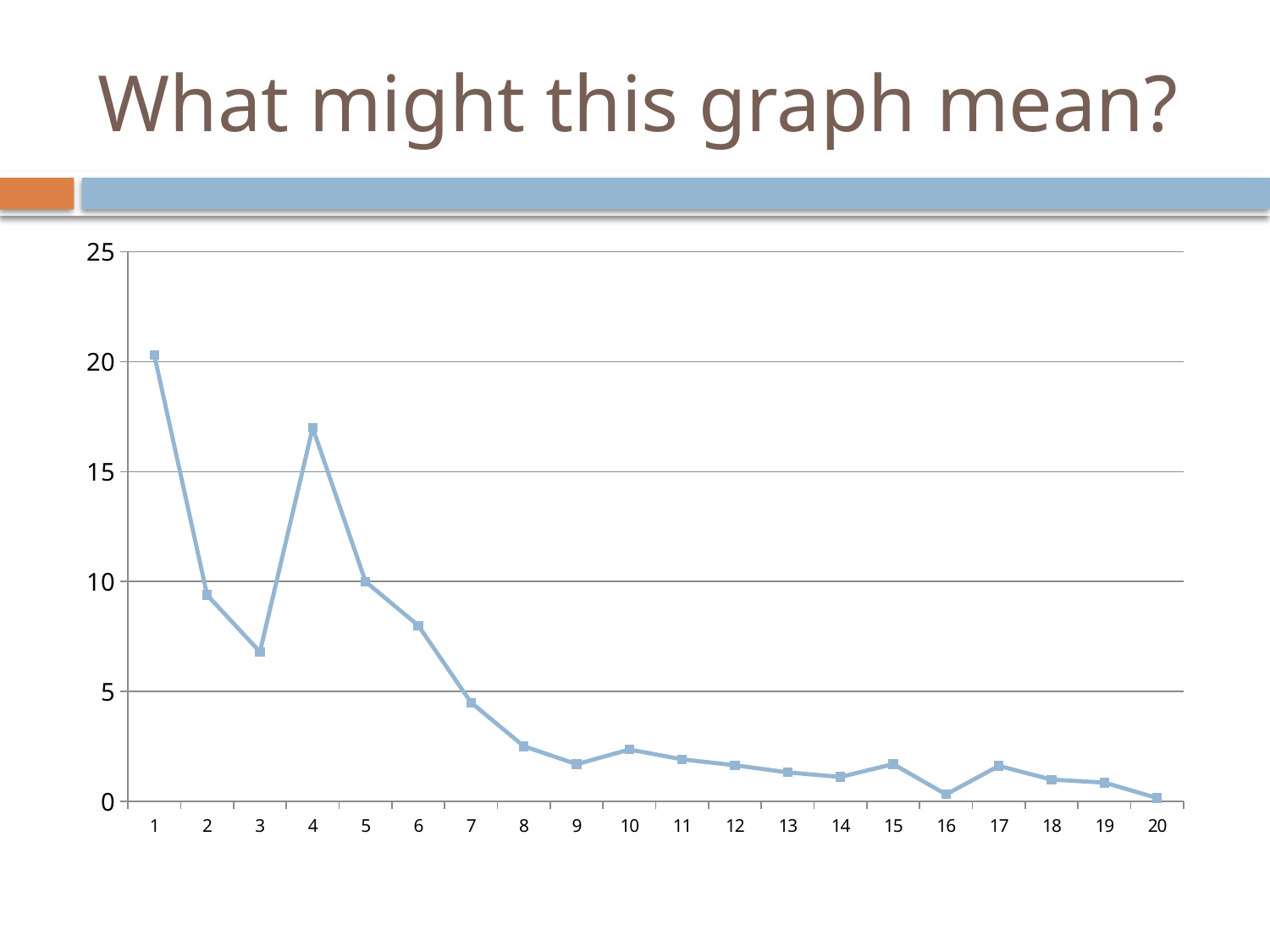
Do the values generally rise or fall from x = 1 to x = 20? fall How many points are plotted along the x axis? 20 What kind of chart is shown on the slide? line chart Is the value at x = 7 greater or less than 5? less Is the value at x = 2 greater or less than 10? less What is the highest value shown on the y axis? 25 Is the value at x = 4 greater or less than 15? greater Which has the larger value, x = 1 or x = 4? 1 Which has the larger value, x = 3 or x = 4? 4 Which x-axis category has the highest value? 1